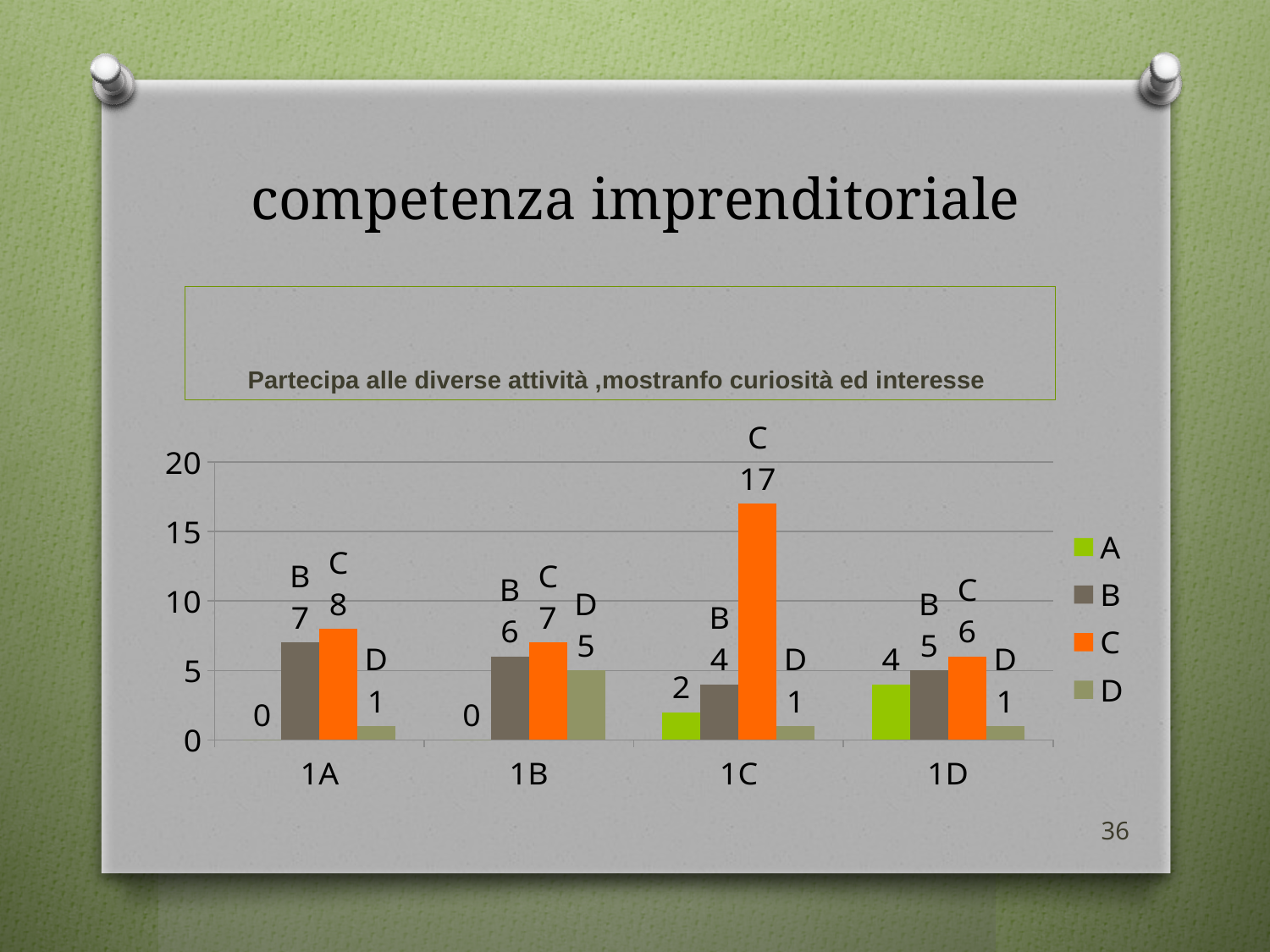
What is the value of series A for category 1D? 4 What kind of chart is shown on the slide? bar chart Which category has the lowest value for series B? 1C How many categories are shown on the x axis? 4 Which is larger: the series B value for 1B or the series B value for 1D? 1B How many series does the legend list? 4 What is the difference between the series C value for 1C and the series C value for 1A? 9 Is the value of series C for category 1C greater or less than 15? greater What is the value of series C for category 1C? 17 What is the value of series D for category 1B? 5 Which category has the highest value for series C? 1C What is the value of series B for category 1A? 7